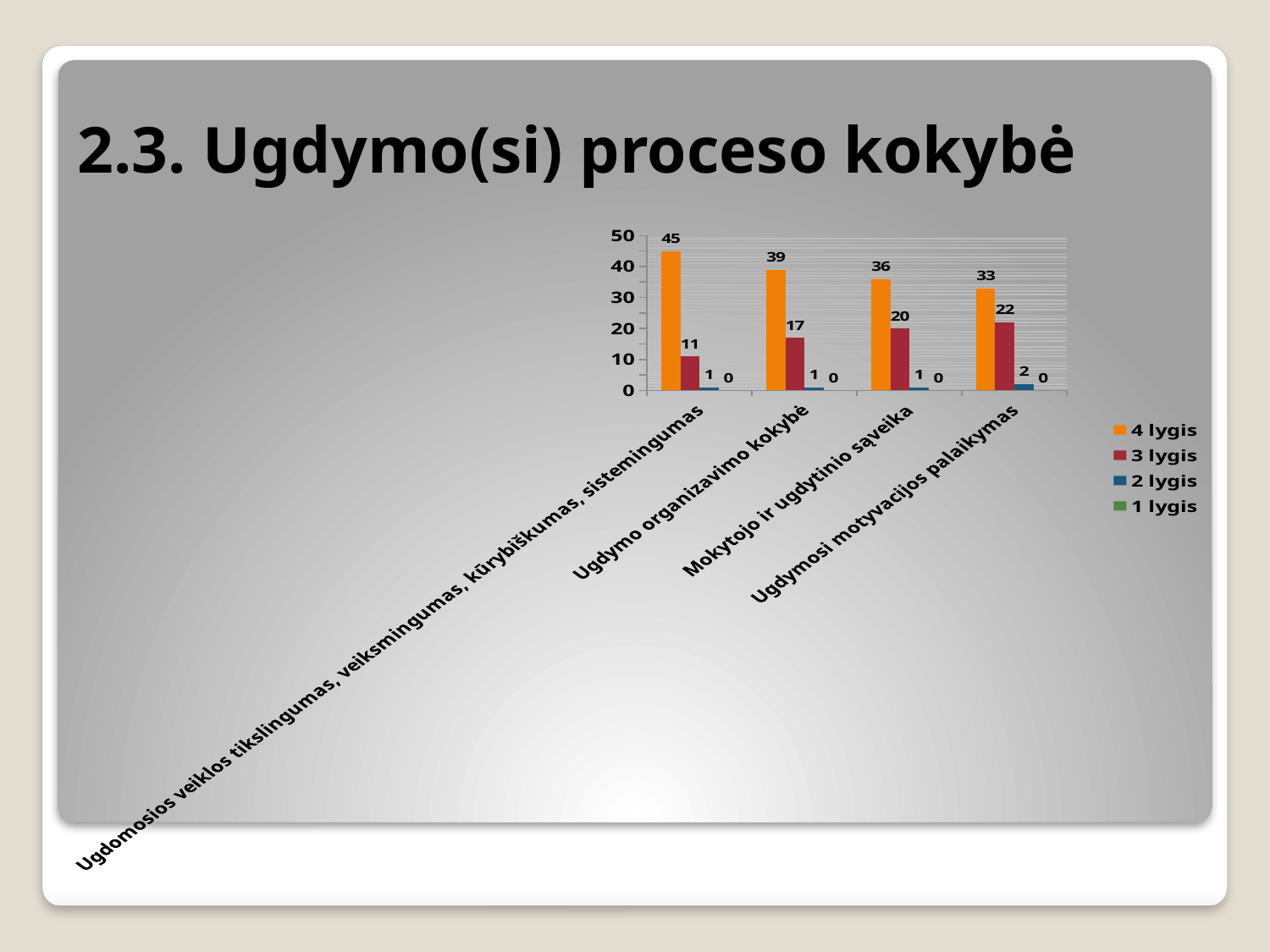
Which category has the highest value for "4 lygis"? Ugdomosios veiklos tikslingumas, veiksmingumas, kūrybiškumas, sistemingumas How many series does the legend list? 4 What kind of chart is shown on the slide? bar chart How many categories are shown on the x axis? 4 What colour represents the "4 lygis" series in the legend? orange What is the value of "3 lygis" for "Ugdymosi motyvacijos palaikymas"? 22 Which category has the lowest value for "3 lygis"? Ugdomosios veiklos tikslingumas, veiksmingumas, kūrybiškumas, sistemingumas Which is larger: the "3 lygis" value for "Ugdymo organizavimo kokybė" or for "Mokytojo ir ugdytinio sąveika"? Mokytojo ir ugdytinio sąveika What is the difference between the "4 lygis" and "3 lygis" values for "Mokytojo ir ugdytinio sąveika"? 16 Do the "4 lygis" values rise or fall from left to right across the categories? fall What is the value of "4 lygis" for "Ugdymo organizavimo kokybė"? 39 What is the value of "2 lygis" for "Mokytojo ir ugdytinio sąveika"? 1